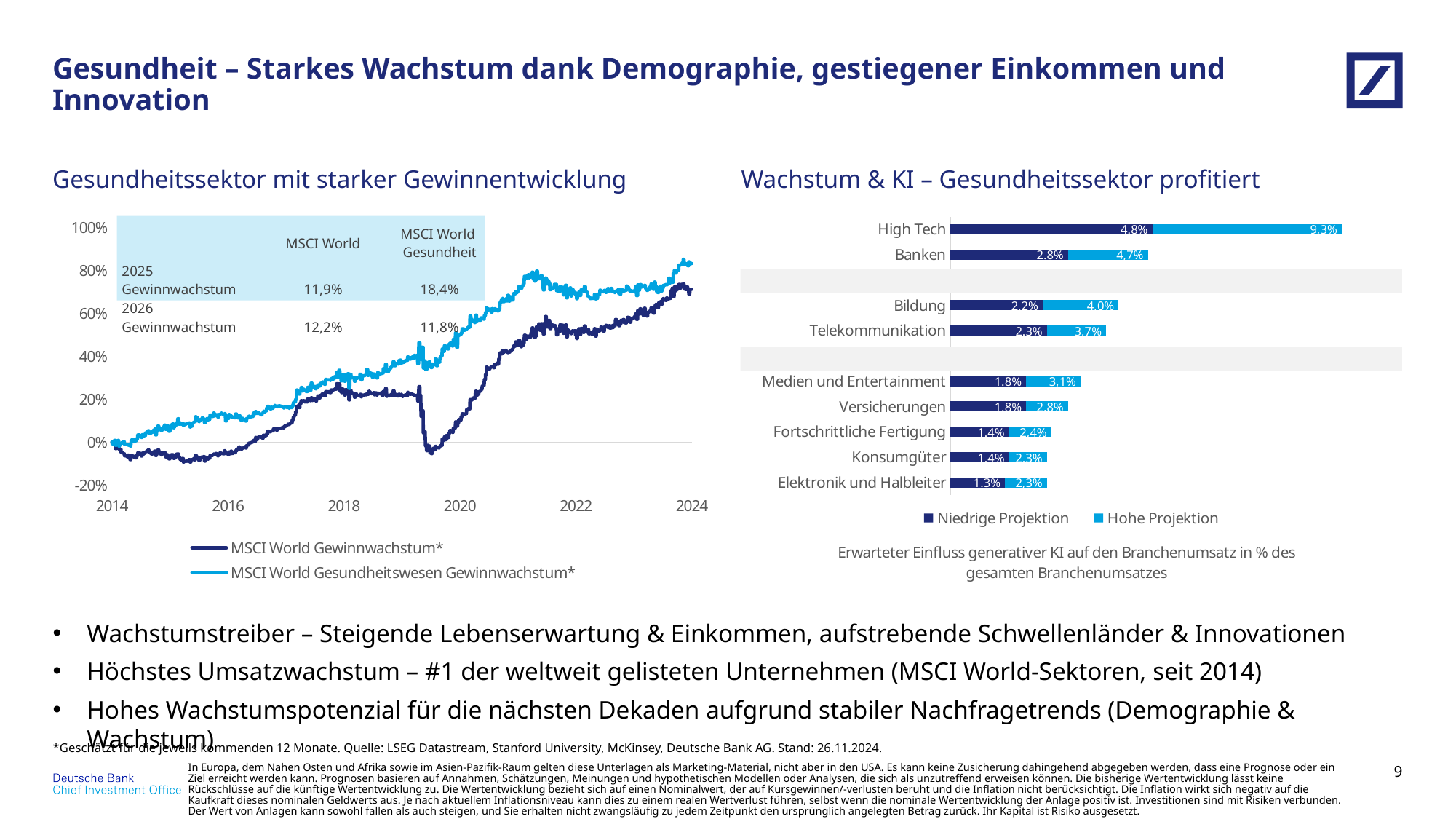
On the chart titled 'Wachstum & KI – Gesundheitssektor profitiert', which category has the lowest Niedrige Projektion value? Elektronik und Halbleiter On the chart titled 'Gesundheitssektor mit starker Gewinnentwicklung', does the MSCI World Gesundheitswesen Gewinnwachstum line generally rise or fall from 2014 to 2024? Rise On the chart titled 'Wachstum & KI – Gesundheitssektor profitiert', what is the Hohe Projektion value for High Tech? 9,3% On the chart titled 'Wachstum & KI – Gesundheitssektor profitiert', what is the difference between the Hohe Projektion and Niedrige Projektion values for Bildung? 1,8% On the chart titled 'Wachstum & KI – Gesundheitssektor profitiert', which category has the highest Hohe Projektion value? High Tech On the chart titled 'Gesundheitssektor mit starker Gewinnentwicklung', what is the 2025 Gewinnwachstum for MSCI World Gesundheit shown in the inset table? 18,4% On the chart titled 'Wachstum & KI – Gesundheitssektor profitiert', how many categories are shown? 9 On the chart titled 'Wachstum & KI – Gesundheitssektor profitiert', what is the Niedrige Projektion value for Banken? 2,8% What kind of chart is the chart titled 'Gesundheitssektor mit starker Gewinnentwicklung'? Line chart On the chart titled 'Wachstum & KI – Gesundheitssektor profitiert', which is larger: the Hohe Projektion for Telekommunikation or the Hohe Projektion for Medien und Entertainment? Telekommunikation On the chart titled 'Wachstum & KI – Gesundheitssektor profitiert', how many series does the legend list? 2 On the chart titled 'Gesundheitssektor mit starker Gewinnentwicklung', what is the 2026 Gewinnwachstum for MSCI World shown in the inset table? 12,2%